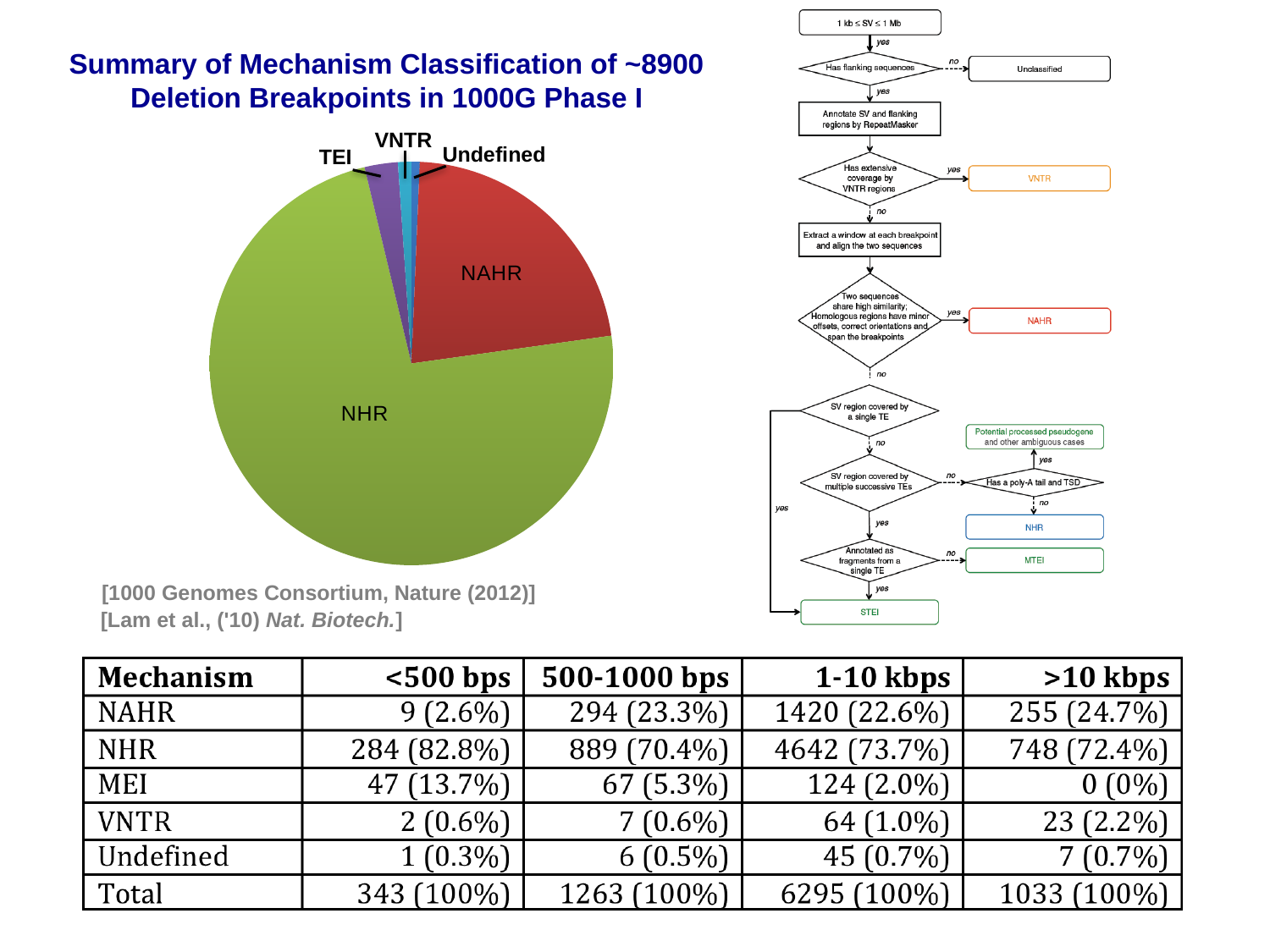
Which mechanism has the second-largest slice in the pie chart? NAHR Name the three small slices labelled at the top of the pie chart. TEI, VNTR, Undefined How many slices does the pie chart have? 5 What is the title of the slide containing the pie chart? Summary of Mechanism Classification of ~8900 Deletion Breakpoints in 1000G Phase I What kind of chart is shown on the left of the slide? pie chart In the pie chart, which slice is larger, NAHR or TEI? NAHR What colour is the NAHR slice in the pie chart? red In the pie chart, which slice is larger, NAHR or NHR? NHR Which mechanism has the largest slice in the pie chart? NHR